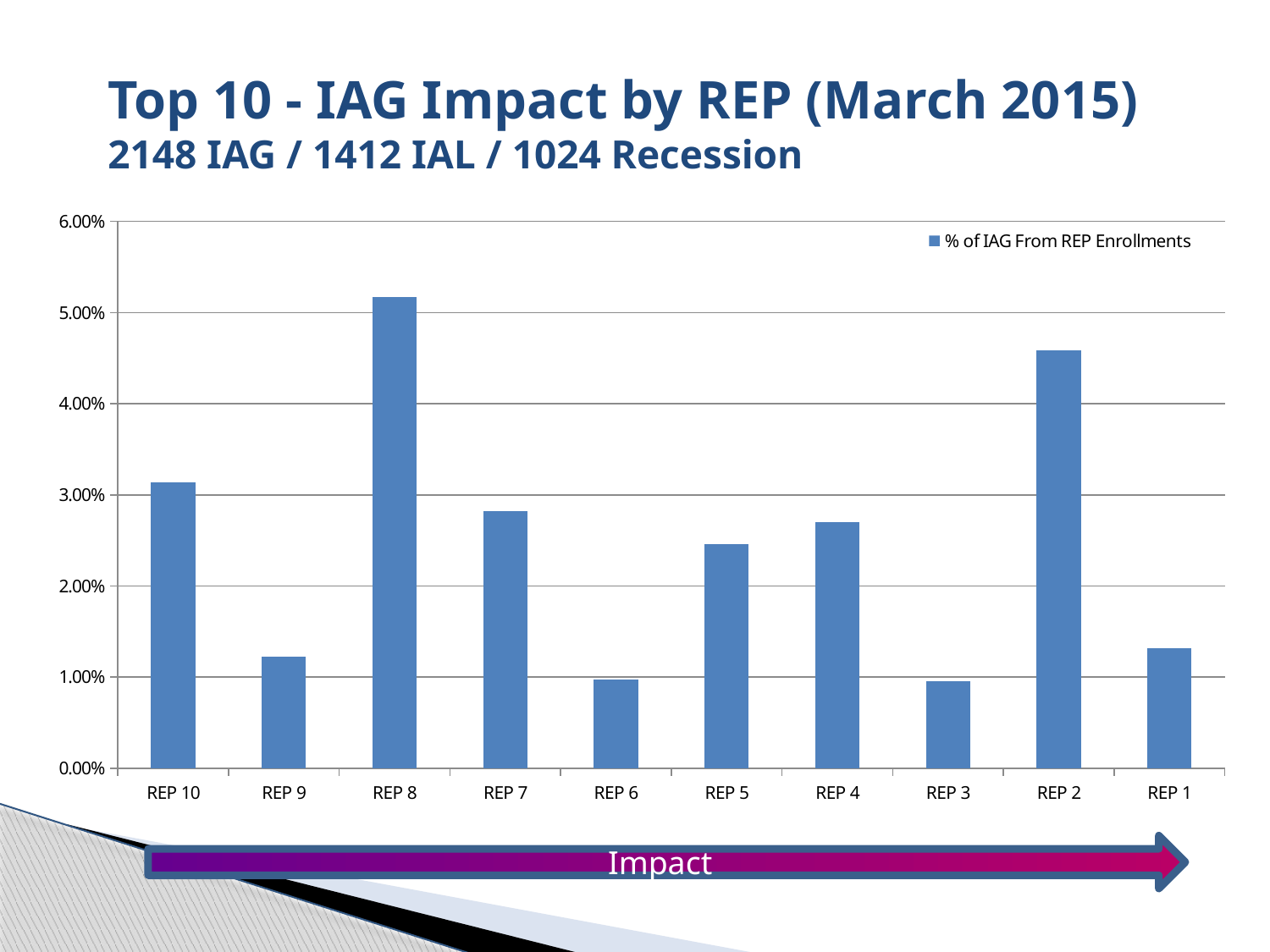
Is the value for REP 10 greater or less than 3.00%? greater What is the series name shown in the chart legend? % of IAG From REP Enrollments What kind of chart is shown on the slide? Bar chart How many series does the legend list? 1 Is the value for REP 7 greater or less than 3.00%? less How many REP categories are plotted on the x axis? 10 Is the value for REP 2 greater or less than 5.00%? less Which is larger, the value for REP 10 or the value for REP 7? REP 10 Which REP has the highest % of IAG From REP Enrollments? REP 8 Which is larger, the value for REP 8 or the value for REP 2? REP 8